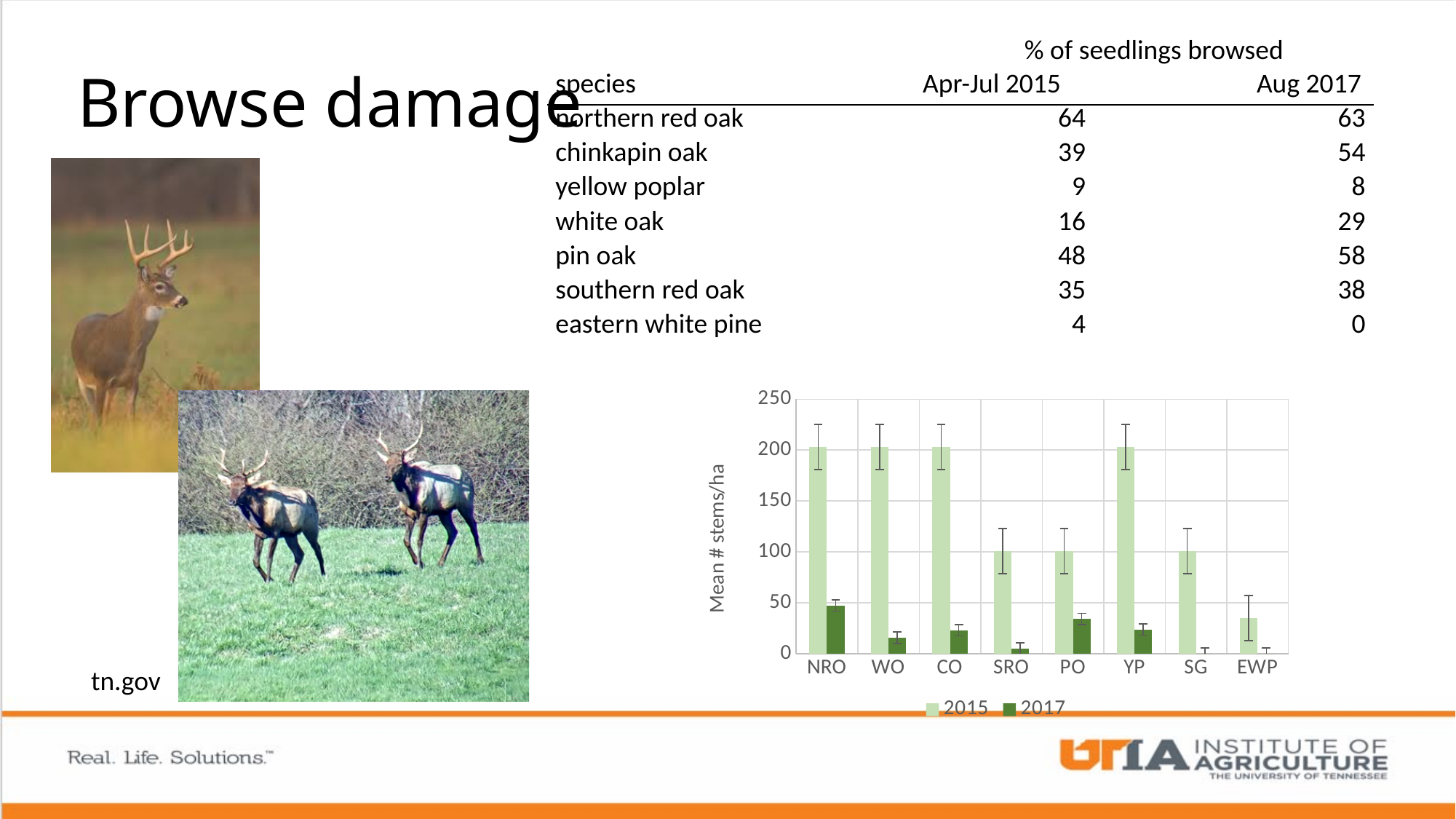
What is the y-axis title of the bar chart? Mean # stems/ha Is the 2015 value for EWP greater or less than 50? less Which category has the lowest 2015 value? EWP For NRO, which is larger, the 2015 value or the 2017 value? 2015 Which category has the highest 2017 value? NRO Is the 2015 value for SRO greater or less than 150? less Is the 2015 value for NRO greater or less than 150? greater What are the two series named in the legend of the bar chart? 2015 and 2017 How many categories are shown on the x axis of the bar chart? 8 What kind of chart is shown on the slide? bar chart How many series does the legend of the bar chart list? 2